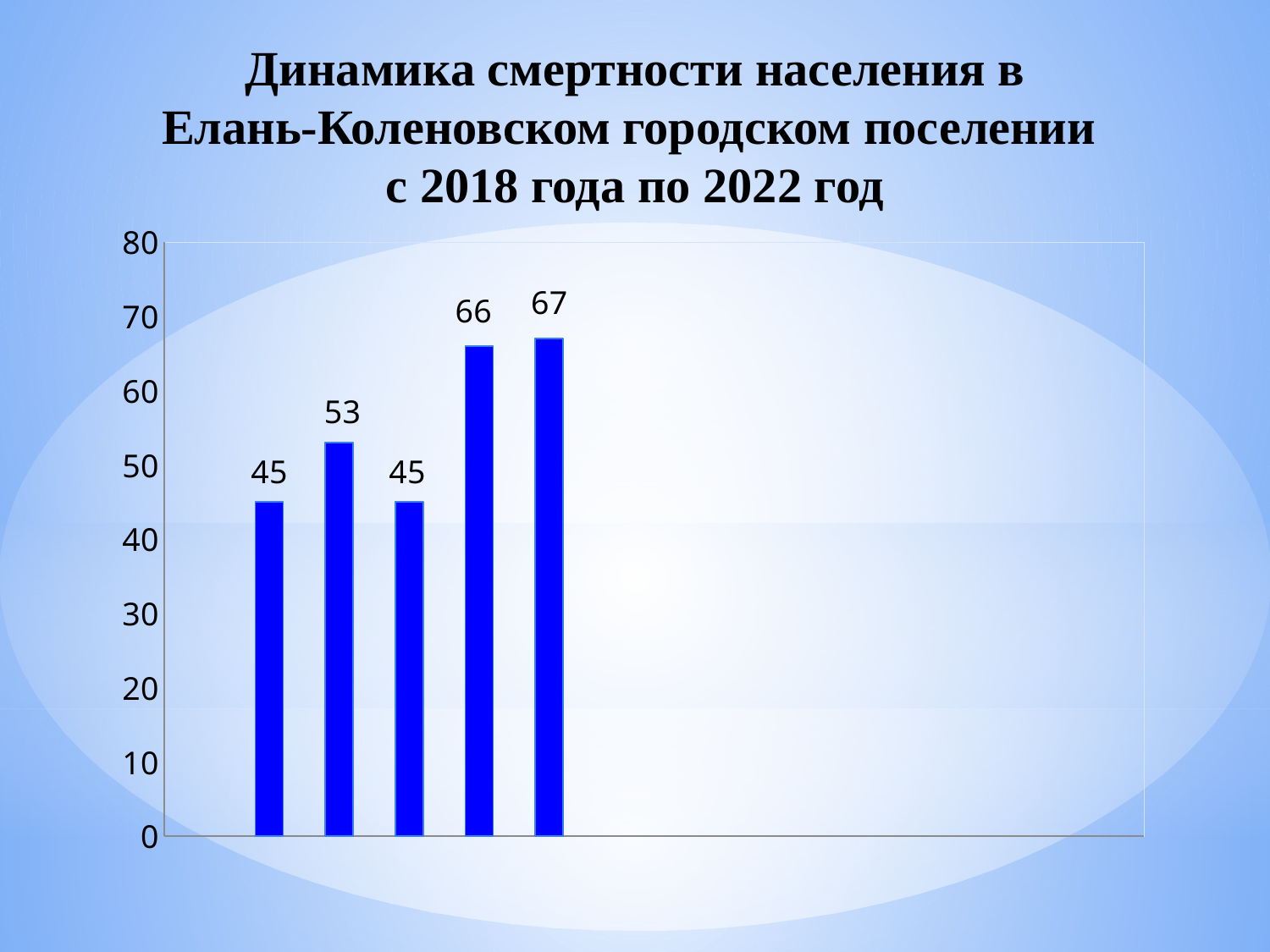
Is the value of the fourth bar greater or less than 60? greater What is the value of the fifth (rightmost) bar? 67 How many bars are plotted in the chart? 5 What is the value of the fourth bar? 66 What is the value of the first (leftmost) bar? 45 Which is larger, the second bar or the fourth bar? the fourth bar What is the difference between the rightmost bar and the leftmost bar? 22 What type of chart is shown on the slide? bar chart According to the chart title, which years does the chart cover? 2018 to 2022 What is the lowest value shown in the chart? 45 What is the value of the second bar? 53 What is the highest value shown in the chart? 67